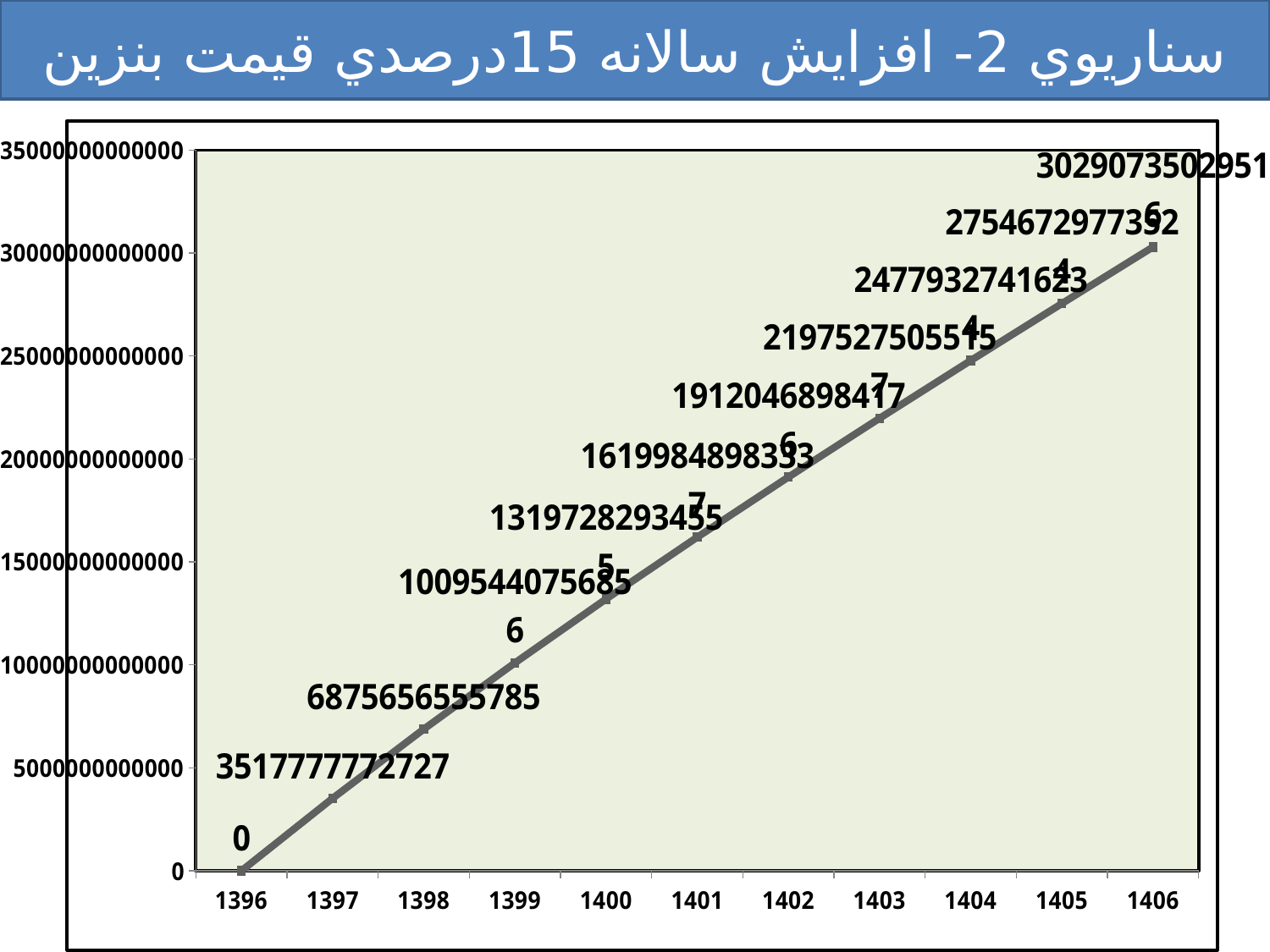
What kind of chart is shown on the slide? line chart Which year has the highest value? 1406 Which year has the lowest value? 1396 Is the value for 1403 greater or less than 25000000000000? less What is the value for 1396? 0 Which year has the larger value, 1402 or 1399? 1402 How many years are plotted along the x axis? 11 Do the values rise or fall from 1396 to 1406? rise What is the value for 1397? 3517777772727 What is the value for 1398? 6875656555785 Is the value for 1400 greater or less than 10000000000000? greater What is the difference between the values for 1398 and 1397? 3357878783058